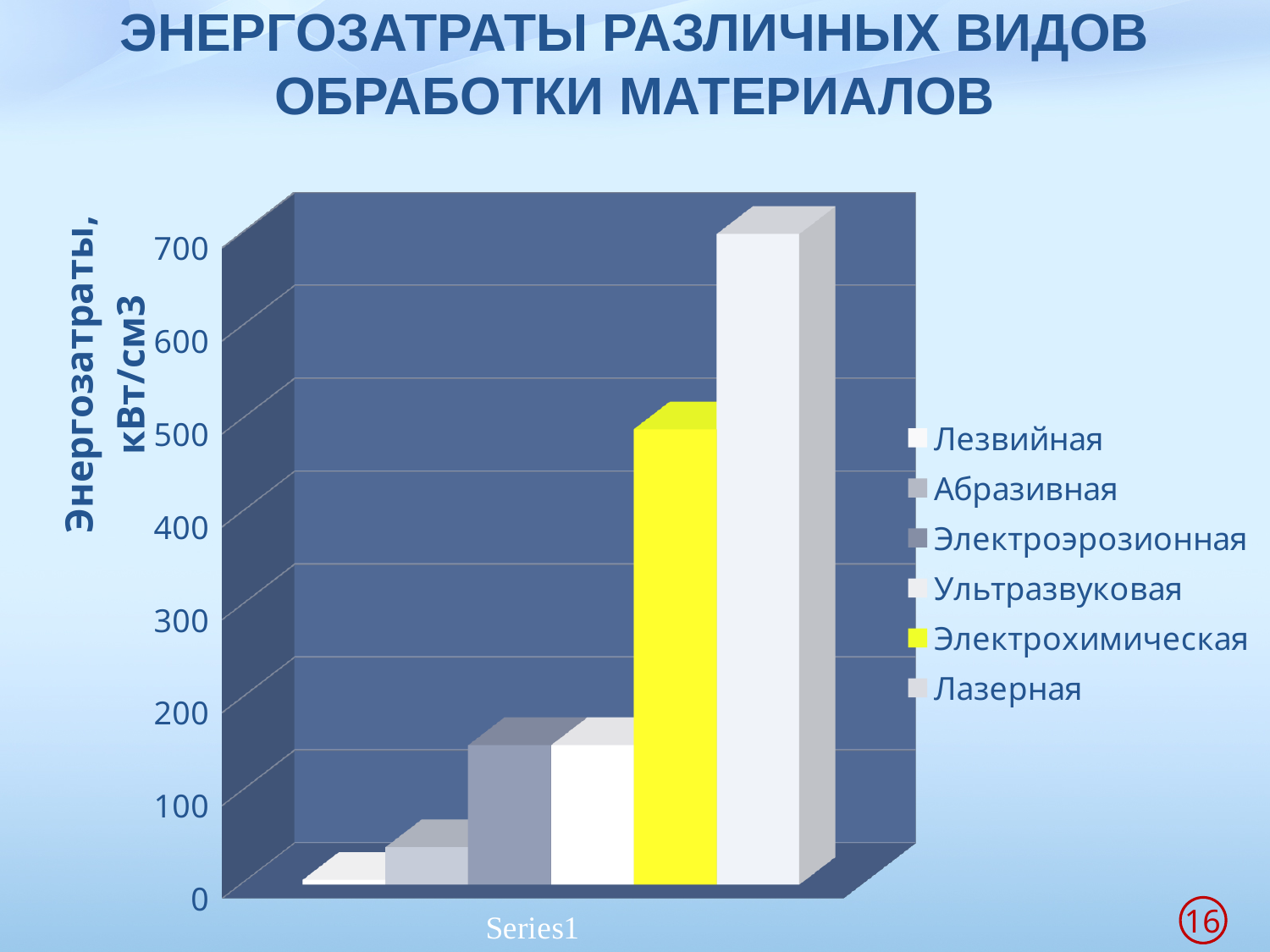
Which legend entry is shown in yellow? Электрохимическая Is the value for Лазерная greater or less than 600? greater Is the value for Электроэрозионная greater or less than 200? less Is the value for Электрохимическая greater or less than 400? greater Which is larger, the value for Лазерная or the value for Электрохимическая? Лазерная What kind of chart is shown on the slide? bar chart What is the label of the vertical axis? Энергозатраты, кВт/см3 How many series does the legend list? 6 Which processing type has the lowest energy consumption? Лезвийная Which is larger, the value for Электрохимическая or the value for Абразивная? Электрохимическая Which processing type has the highest energy consumption? Лазерная